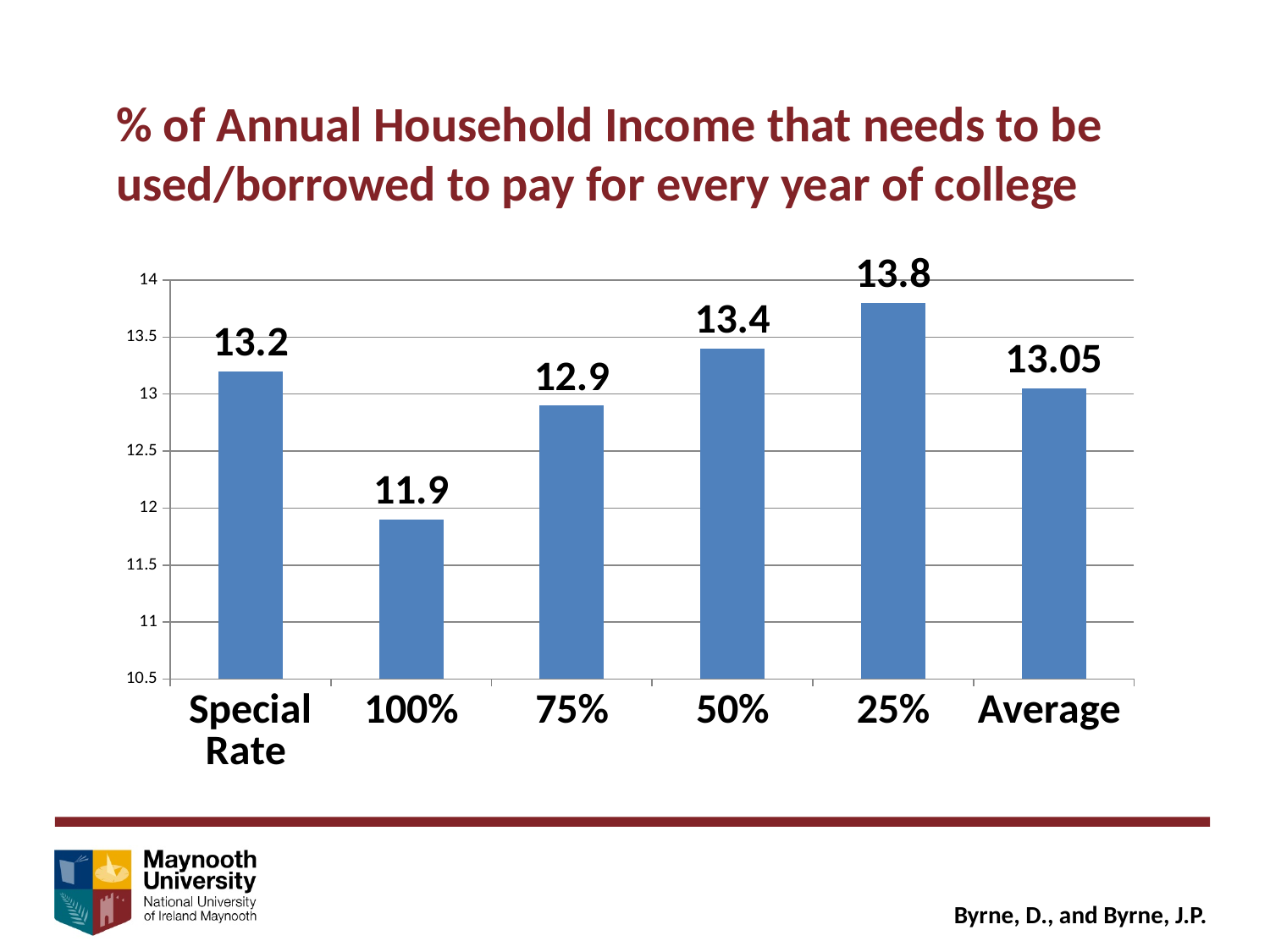
What is the title of the chart on the slide? % of Annual Household Income that needs to be used/borrowed to pay for every year of college What is the value for the Special Rate category? 13.2 How many categories are shown on the x axis? 6 Which is larger, the value for 75% or the value for Special Rate? Special Rate What is the value for the Average category? 13.05 What is the value for the 100% category? 11.9 What is the difference between the values for 25% and 100%? 1.9 What kind of chart is shown on the slide? Bar chart Which category has the lowest value? 100% What is the difference between the values for 50% and 75%? 0.5 What is the value for the 25% category? 13.8 Which category has the highest value? 25%